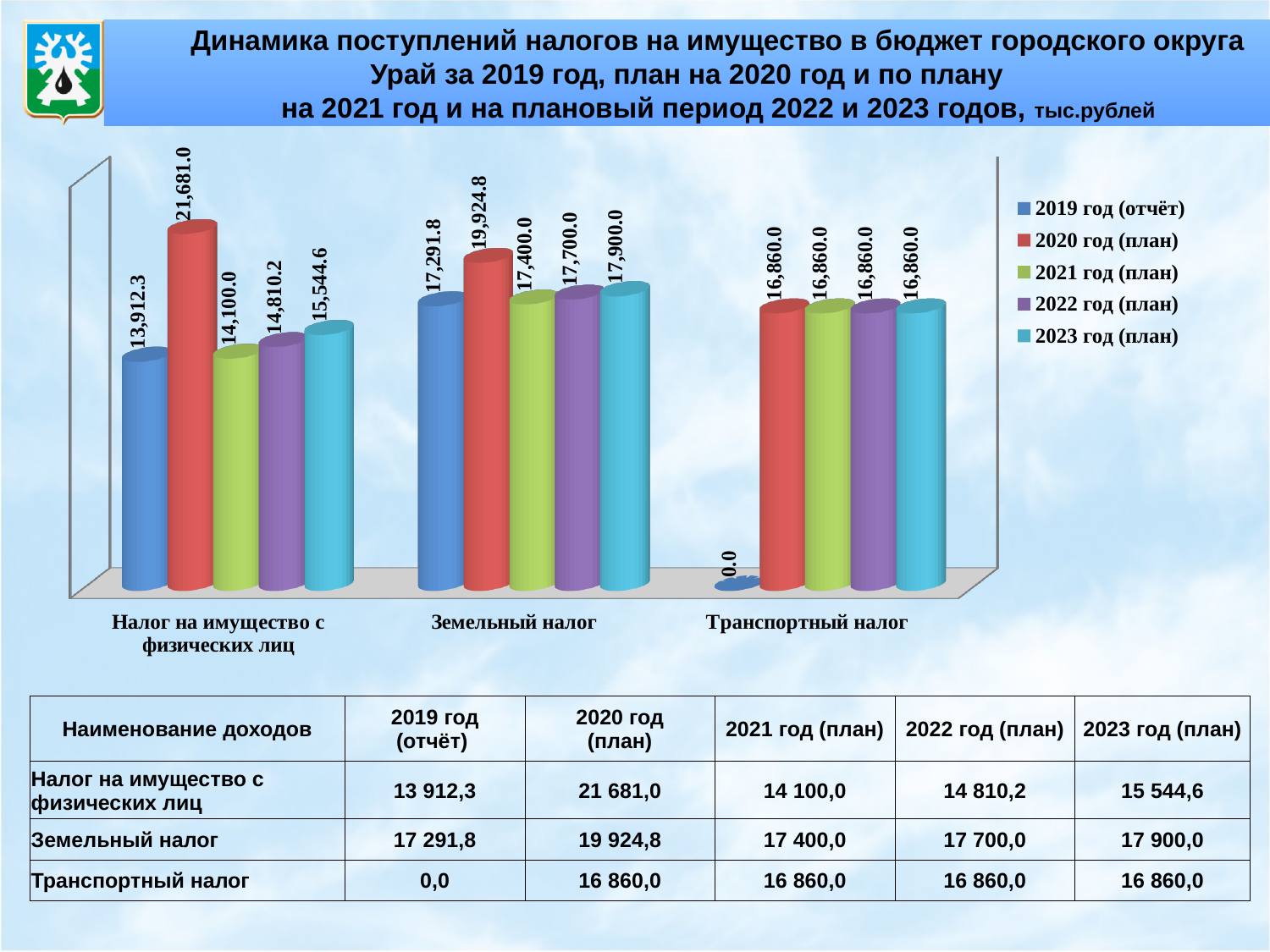
What is the value for Земельный налог in the 2019 год (отчёт) series? 17,291.8 What is the difference between the 2020 год (план) and 2019 год (отчёт) values for Налог на имущество с физических лиц? 7,768.7 What kind of chart is shown on the slide? Bar chart Do the values for Земельный налог rise or fall from 2021 год (план) to 2023 год (план)? Rise Which series has the highest value for Налог на имущество с физических лиц? 2020 год (план) What is the value for Транспортный налог in the 2019 год (отчёт) series? 0.0 How many categories are shown on the x axis of the chart? 3 Which series has the lowest value for Транспортный налог? 2019 год (отчёт) How many series does the chart legend list? 5 Which is larger for the 2021 год (план) series: Земельный налог or Налог на имущество с физических лиц? Земельный налог What is the value for Земельный налог in the 2023 год (план) series? 17,900.0 What is the value for Налог на имущество с физических лиц in the 2020 год (план) series? 21,681.0